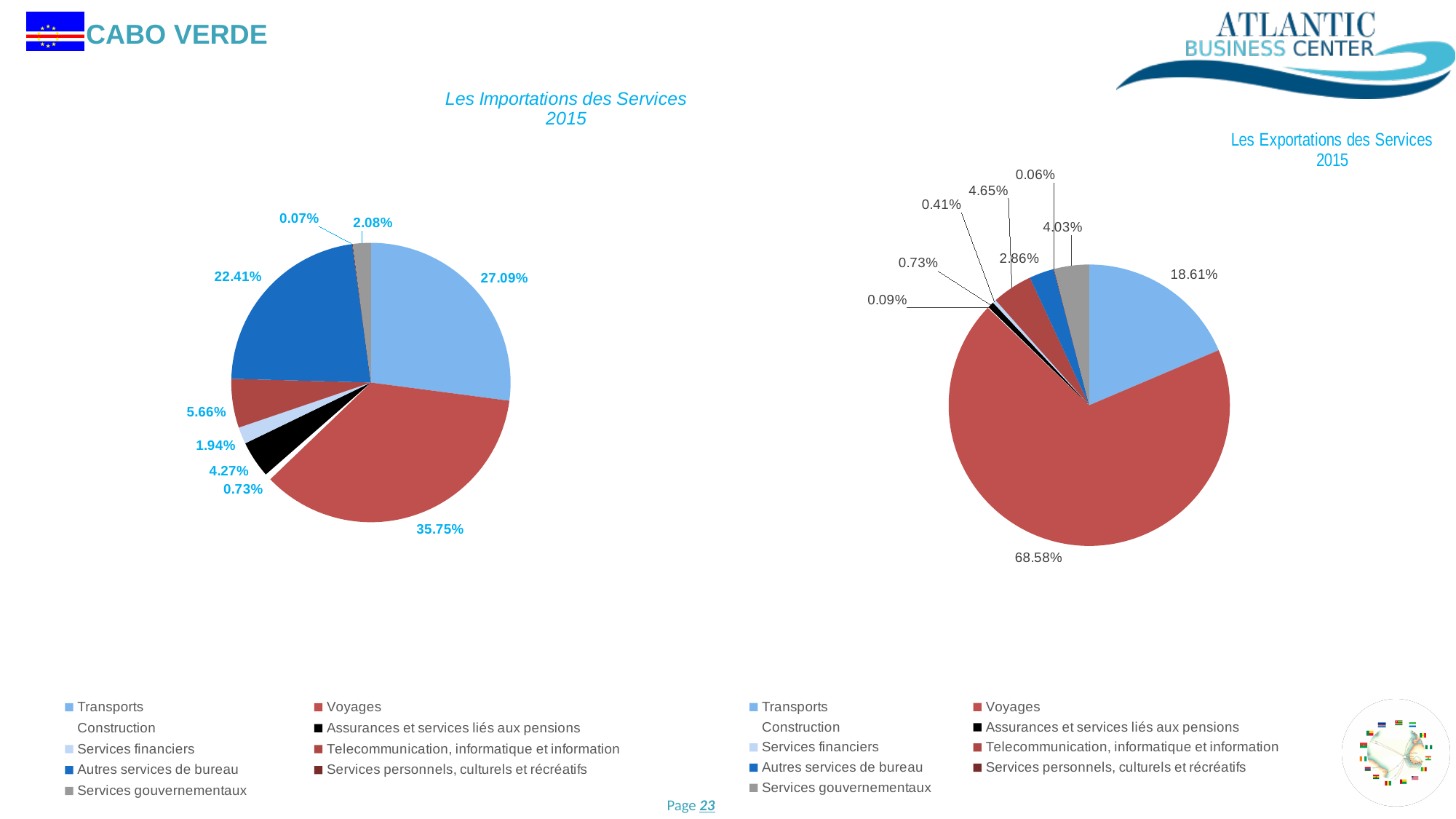
In the 'Les Importations des Services 2015' chart, what share does Voyages have? 35.75% In the 'Les Importations des Services 2015' chart, what share does Autres services de bureau have? 22.41% In the 'Les Exportations des Services 2015' chart, what share does Services gouvernementaux have? 4.03% In the 'Les Exportations des Services 2015' chart, what share does Transports have? 18.61% In the 'Les Exportations des Services 2015' chart, what share does Voyages have? 68.58% In the 'Les Importations des Services 2015' chart, which category has the largest share? Voyages In the 'Les Exportations des Services 2015' chart, which is larger: Telecommunication, informatique et information or Autres services de bureau? Telecommunication, informatique et information How many categories does the legend of the 'Les Importations des Services 2015' chart list? 9 In the 'Les Importations des Services 2015' chart, what share does Transports have? 27.09% What kind of chart is 'Les Exportations des Services 2015'? Pie chart In the 'Les Exportations des Services 2015' chart, what is the combined share of Transports and Voyages? 87.19% In the 'Les Importations des Services 2015' chart, what is the difference between the Voyages share and the Transports share? 8.66%